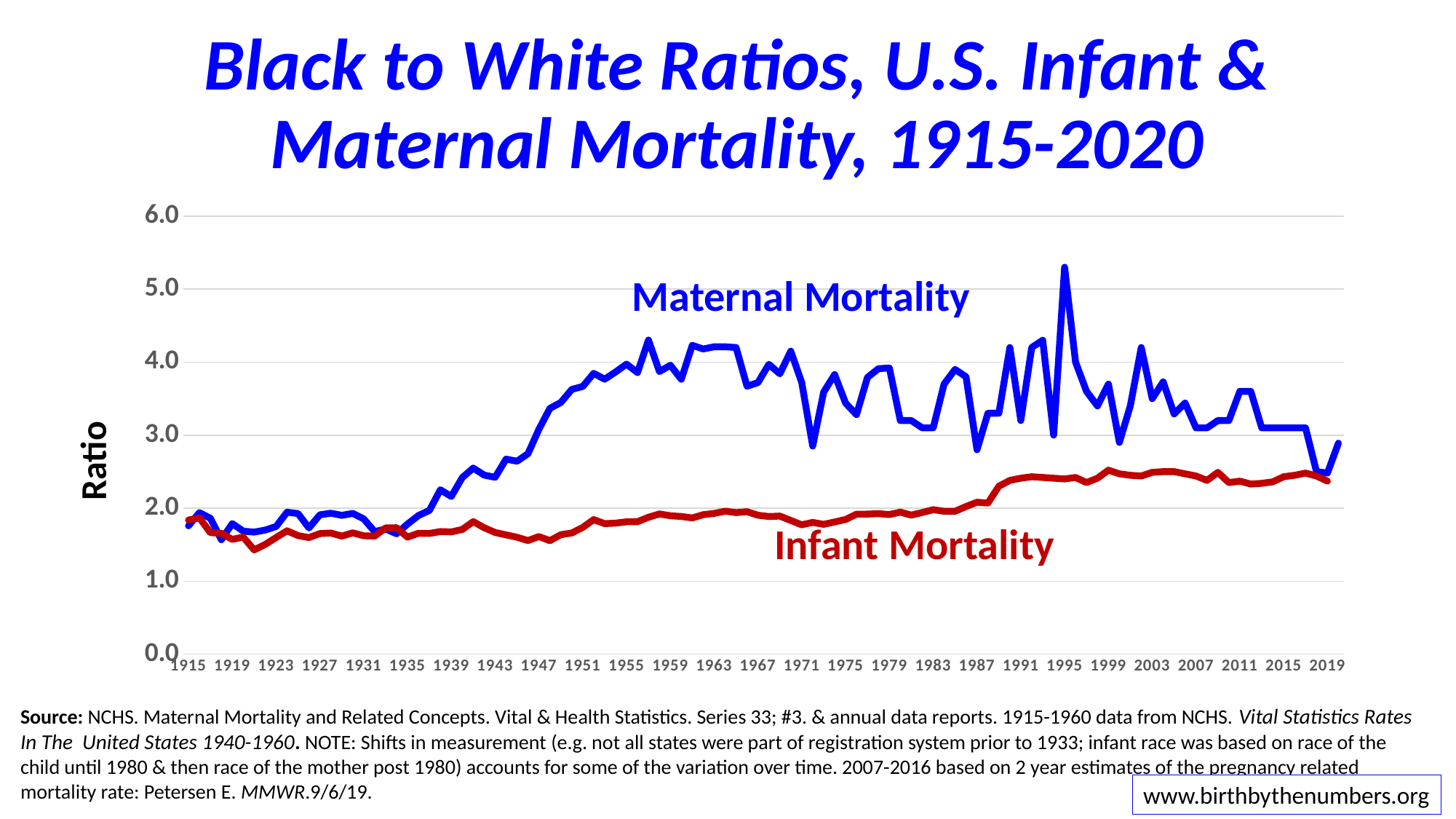
Is the Maternal Mortality ratio in 1963 greater or less than 4.0? greater Which series reaches the highest ratio anywhere on the chart? Maternal Mortality Is the Infant Mortality ratio in 1947 greater or less than 2.0? less What is the title of the chart? Black to White Ratios, U.S. Infant & Maternal Mortality, 1915-2020 Which series is higher in 1963, Maternal Mortality or Infant Mortality? Maternal Mortality How many series are plotted on the chart? 2 Is the Infant Mortality ratio in 1999 greater or less than 2.0? greater Does the Maternal Mortality ratio rise or fall between 1935 and 1955? rise What is the label on the y axis of the chart? Ratio What kind of chart is shown on the slide? line chart